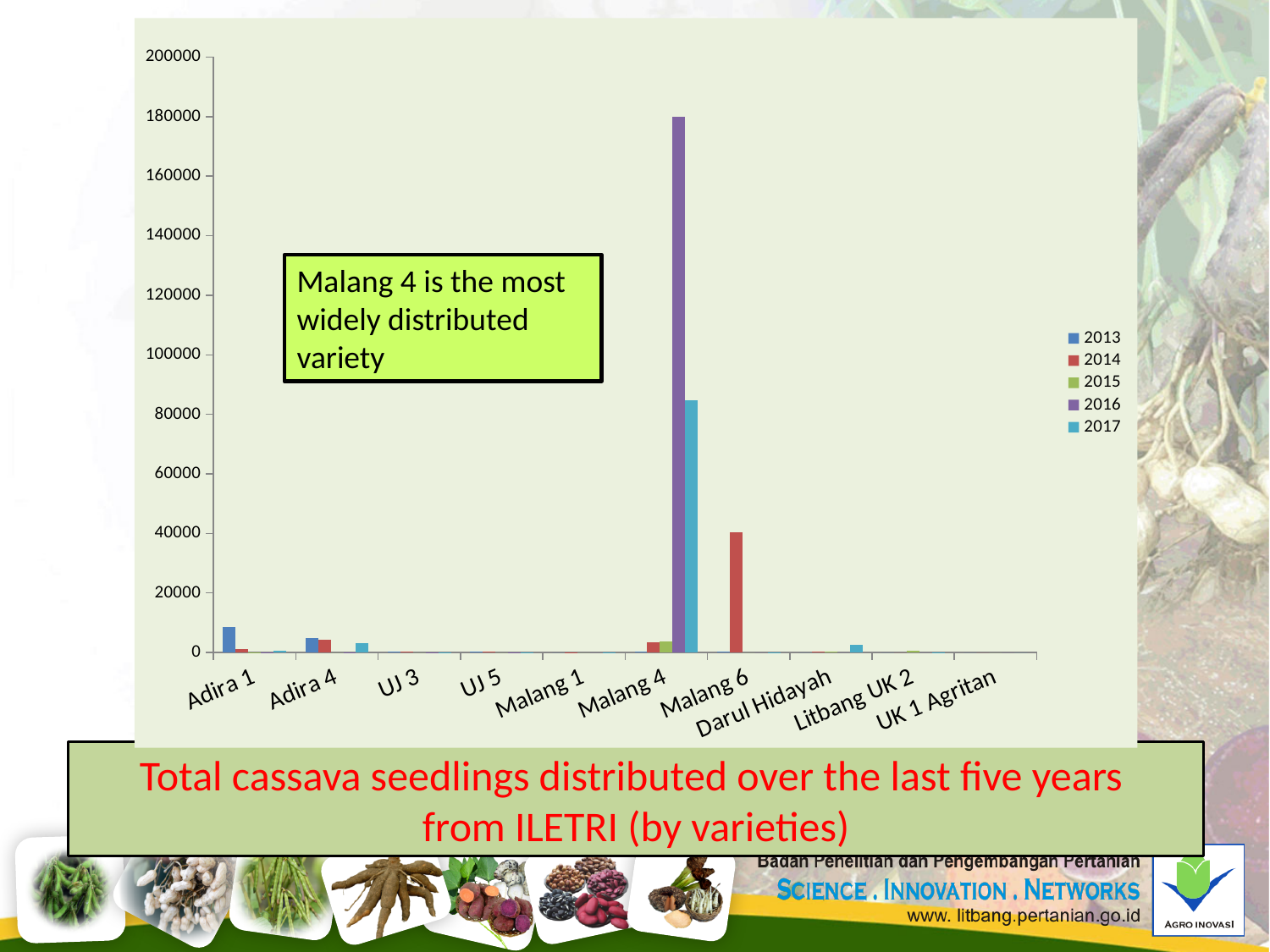
How many varieties (categories) are shown on the x axis of the chart? 10 Is the 2014 value for Malang 6 greater or less than 20000? greater Which is larger: the 2016 value for Malang 4 or the 2014 value for Malang 6? 2016 value for Malang 4 How many series does the chart's legend list? 5 Is the 2017 value for Malang 4 greater or less than 60000? greater Which year is shown in purple in the chart's legend? 2016 Is the 2013 value for Adira 1 greater or less than 20000? less Which year's bar is the tallest for Malang 4? 2016 Which variety has the tallest bar in the chart? Malang 4 According to the callout box on the chart, which variety is the most widely distributed? Malang 4 What kind of chart is shown on the slide? bar chart